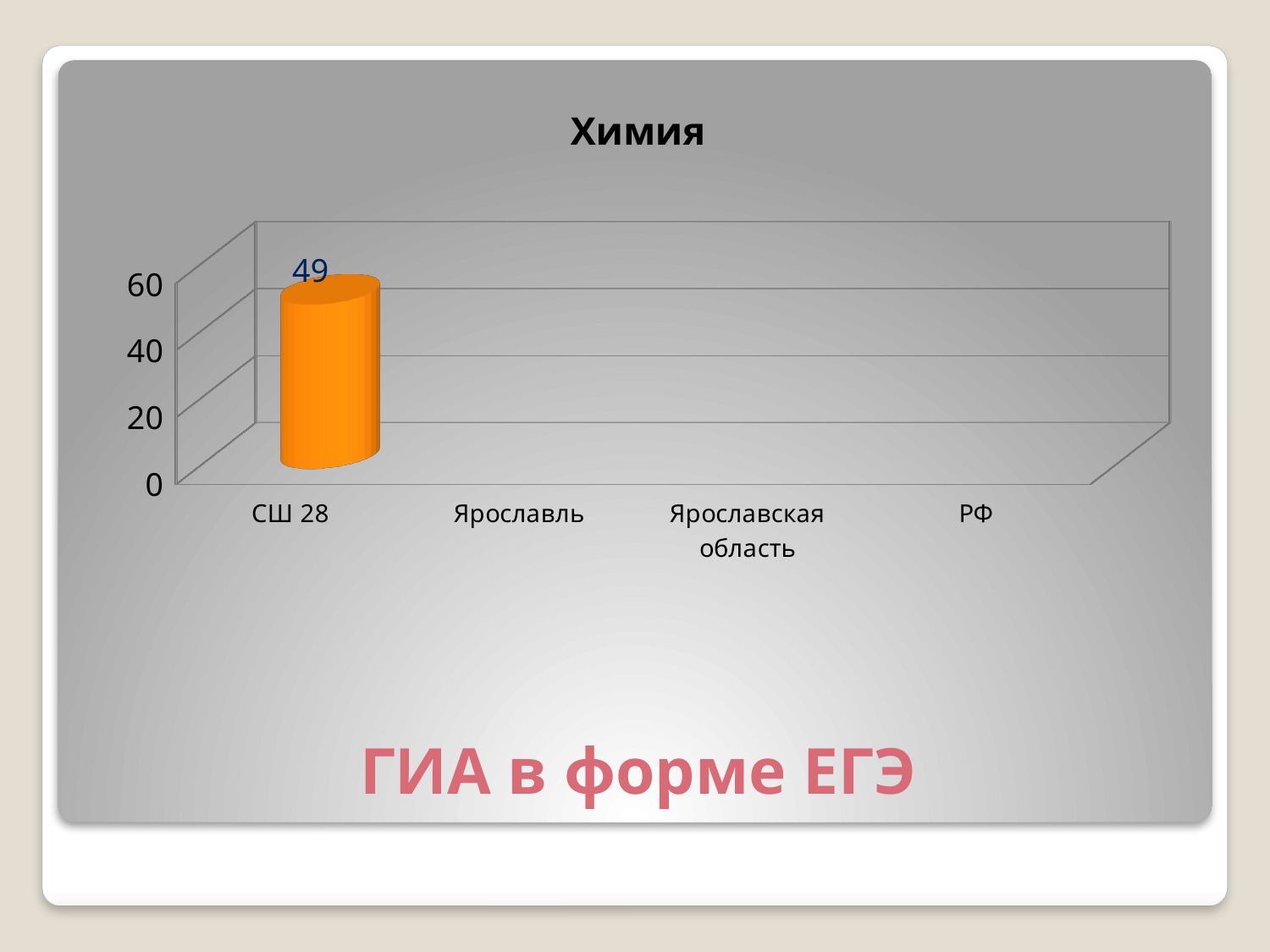
How many categories are listed on the x axis of the chart? 4 How many bars are actually plotted in the chart? 1 What is the title of the chart? Химия Is the value for СШ 28 greater or less than 60? less Is the value for СШ 28 greater or less than 40? greater What kind of chart is shown on the slide? bar chart What is the value shown for СШ 28 in the Химия chart? 49 What is the highest tick value shown on the vertical axis? 60 What colour is the bar for СШ 28? orange Which category has the highest value in the chart? СШ 28